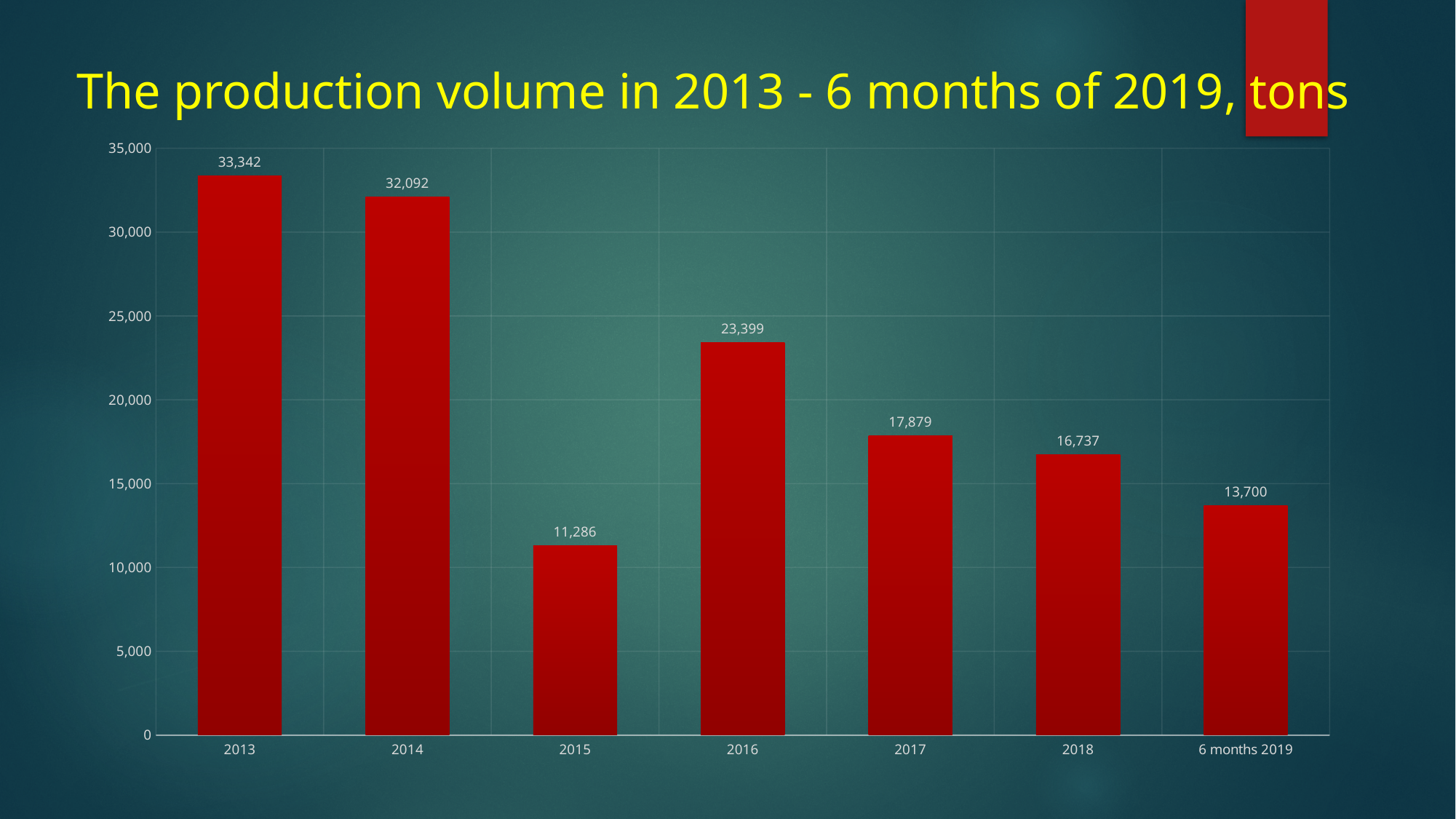
What was the production volume in 2015? 11,286 What is the difference in production volume between 2017 and 2018? 1,142 What is the difference in production volume between 2013 and 2014? 1,250 What was the production volume in the 6 months of 2019? 13,700 Which year had the highest production volume? 2013 What was the production volume in 2013? 33,342 How many periods are shown on the x axis? 7 Is the production volume for 2018 greater or less than 15,000? greater What kind of chart is shown on the slide? bar chart What is the title of the chart? The production volume in 2013 - 6 months of 2019, tons Which period had the lowest production volume? 2015 Which had a larger production volume, 2016 or 2017? 2016